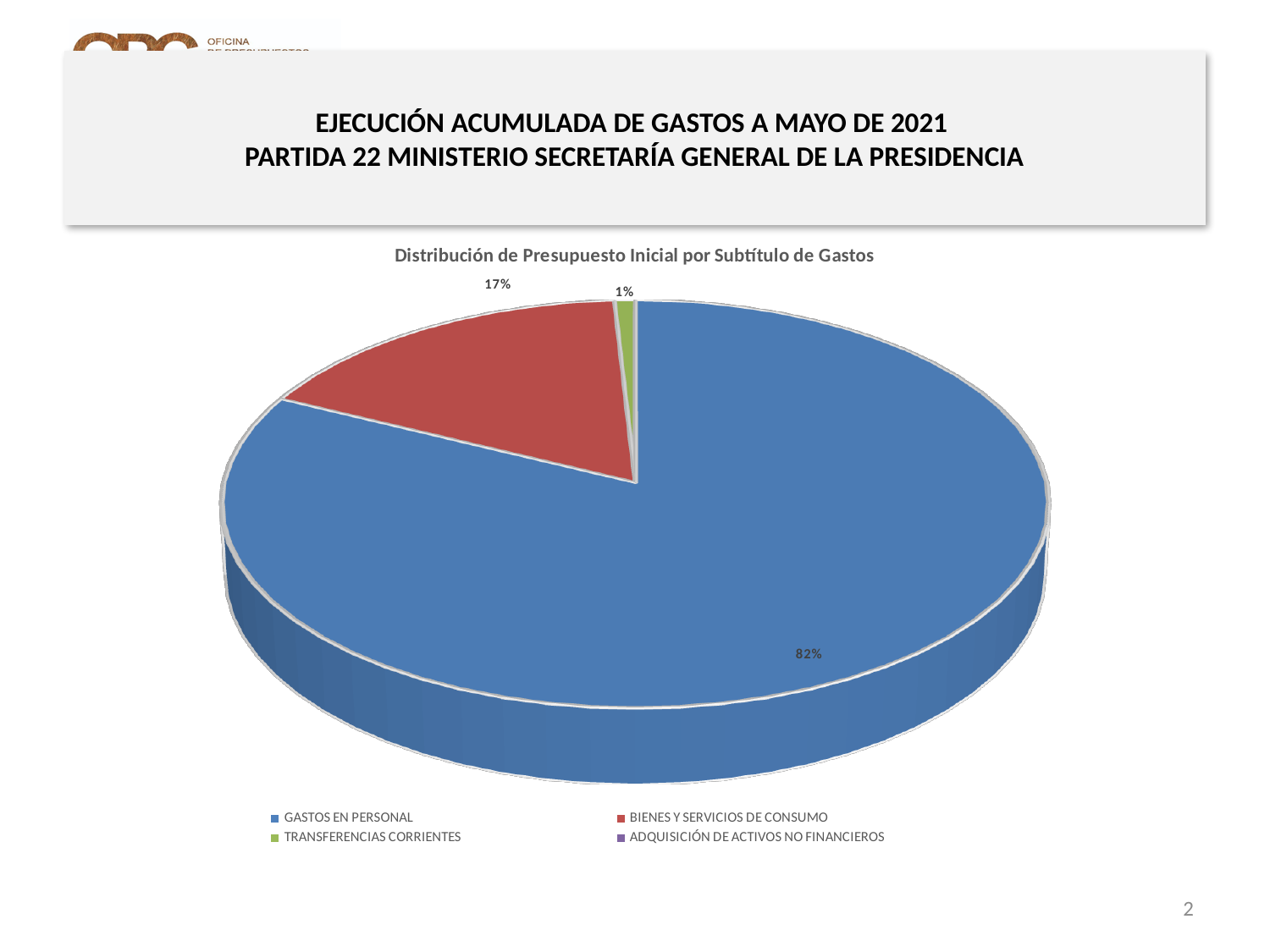
What share of the pie does BIENES Y SERVICIOS DE CONSUMO represent? 17% By how many percentage points does the GASTOS EN PERSONAL share exceed the BIENES Y SERVICIOS DE CONSUMO share? 65 percentage points Which is larger, the share for BIENES Y SERVICIOS DE CONSUMO or the share for TRANSFERENCIAS CORRIENTES? BIENES Y SERVICIOS DE CONSUMO What share of the pie does TRANSFERENCIAS CORRIENTES represent? 1% How many categories does the legend list? 4 What share of the pie does GASTOS EN PERSONAL represent? 82% What colour is the slice for BIENES Y SERVICIOS DE CONSUMO? Red What is the title of the chart? Distribución de Presupuesto Inicial por Subtítulo de Gastos What kind of chart is shown on the slide? Pie chart Which of the labeled slices is the smallest? TRANSFERENCIAS CORRIENTES Which category has the largest slice of the pie? GASTOS EN PERSONAL Is the share for GASTOS EN PERSONAL greater or less than 50%? greater